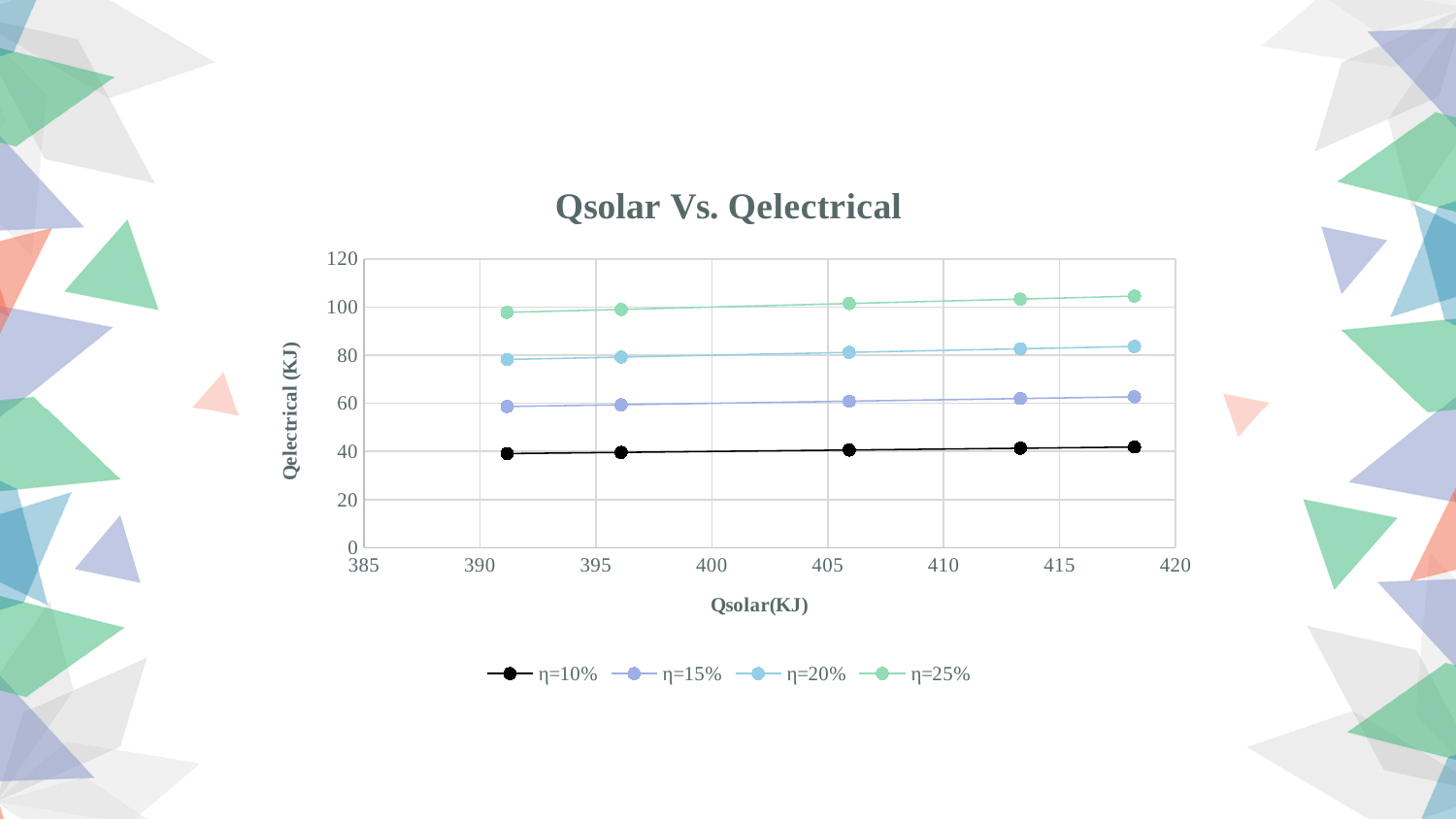
Do the Qelectrical values for the η=25% series rise or fall as Qsolar increases? rise How many series does the legend list? 4 What kind of chart is shown on the slide? line chart Is the Qelectrical value for η=25% at the highest Qsolar point greater or less than 100? greater What is the label of the vertical axis? Qelectrical (KJ) Are the Qelectrical values for the η=10% series greater or less than 60? less What is the title of the chart? Qsolar Vs. Qelectrical How many data points are plotted for the η=25% series? 5 Which series has the lowest Qelectrical values across the chart? η=10% Are the Qelectrical values for the η=20% series greater or less than 100? less At the same Qsolar value, which series has the larger Qelectrical value, η=20% or η=15%? η=20% Which series has the highest Qelectrical values across the chart? η=25%